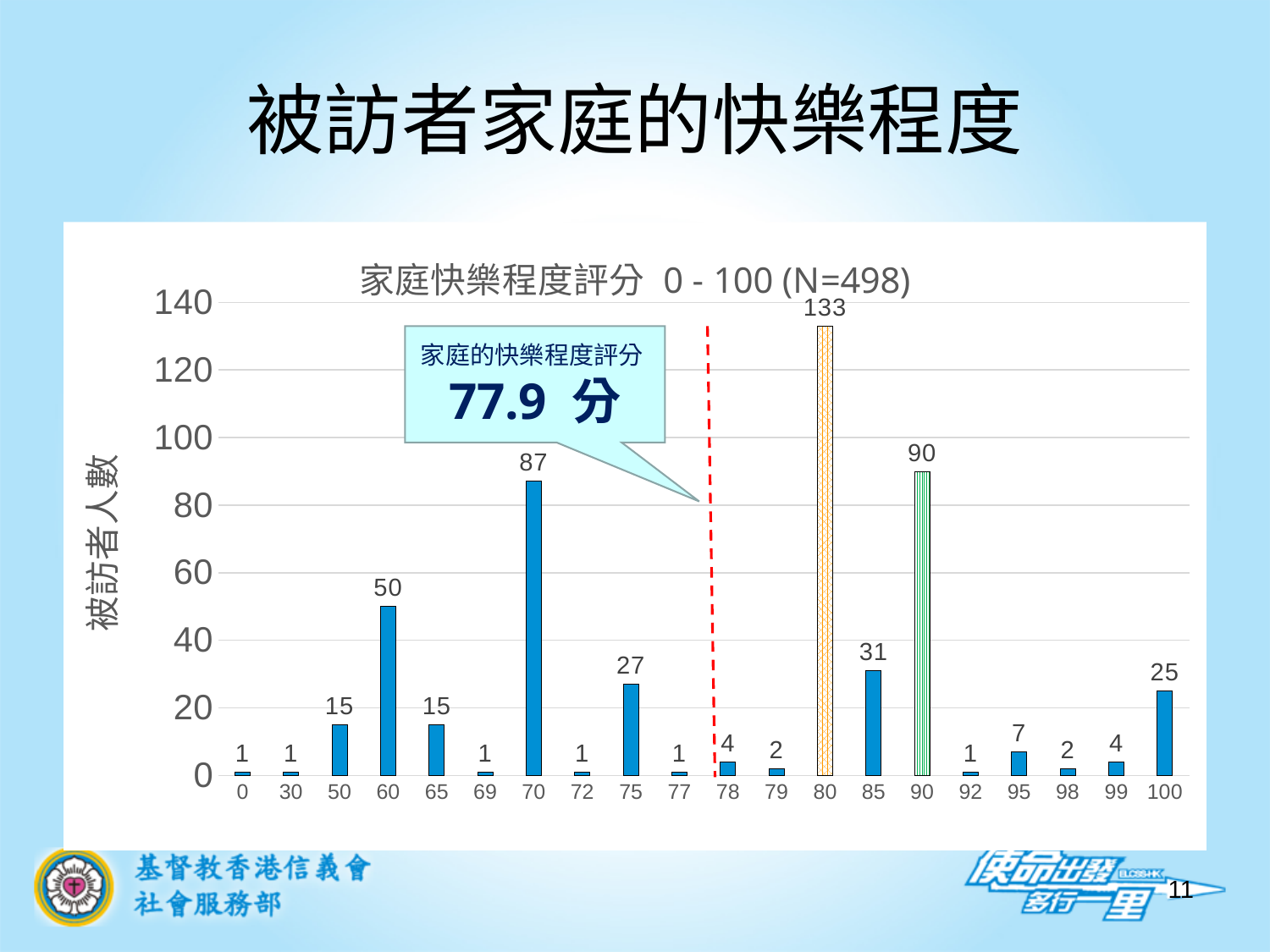
Which rating has the highest number of respondents? 80 How many respondents gave a rating of 60? 50 What is the difference between the number of respondents rating 70 and those rating 60? 37 How many rating categories are shown on the x axis? 20 Which has more respondents: rating 85 or rating 75? 85 What is the sample size (N) stated in the chart title? 498 What type of chart is shown on the slide? Bar chart What is the number of respondents who rated their family happiness 80? 133 What is the difference between the number of respondents rating 80 and those rating 90? 43 What is the average family happiness score shown in the callout box? 77.9 分 How many respondents gave a rating of 100? 25 What is the number of respondents who rated their family happiness 70? 87